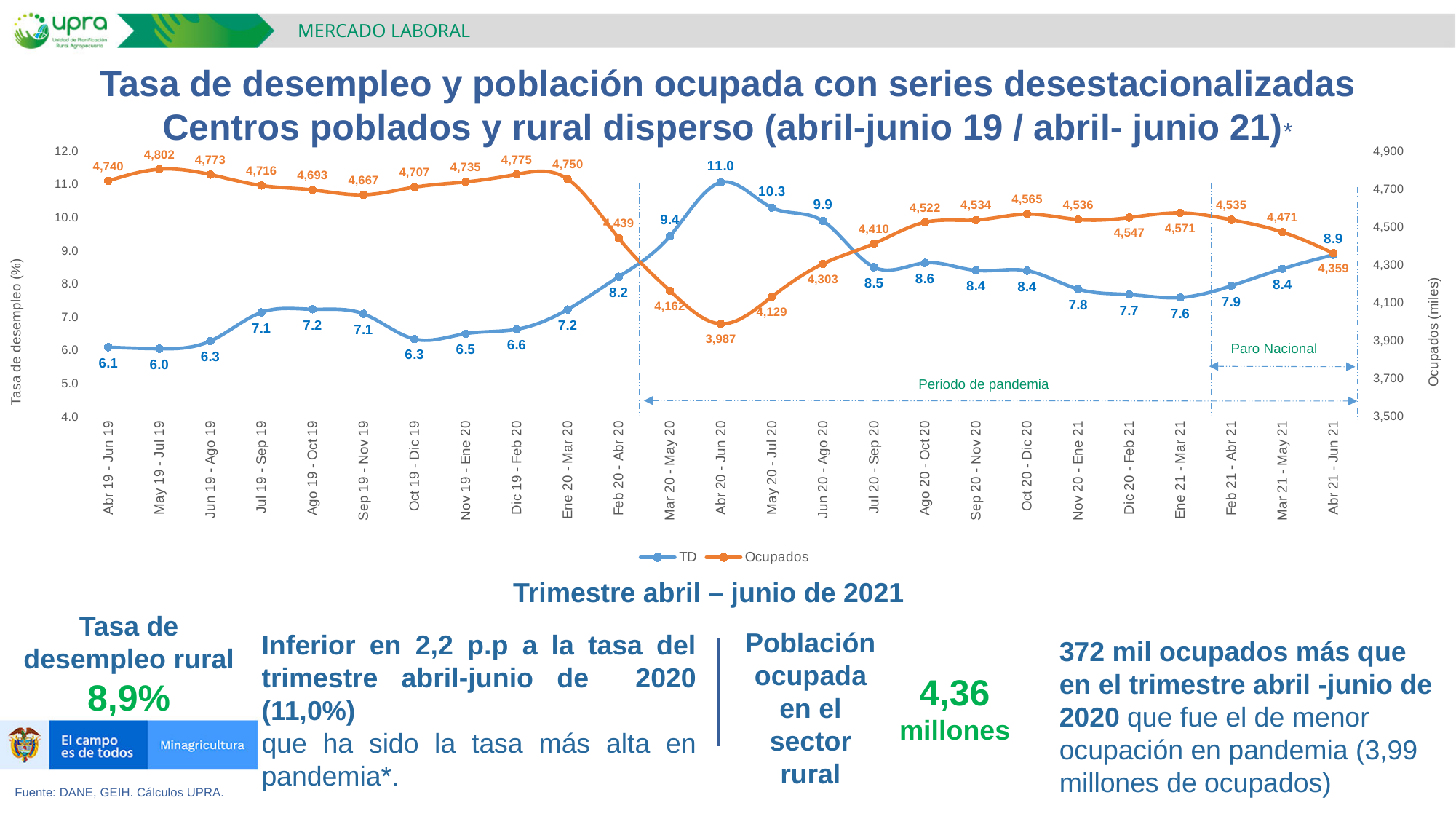
What is the Ocupados value for Abr 20 - Jun 20? 3,987 What is the Ocupados value for Oct 20 - Dic 20? 4,565 What is the TD (unemployment rate) value for Abr 20 - Jun 20? 11.0 In which period is the Ocupados series at its lowest? Abr 20 - Jun 20 What is the difference in Ocupados between Abr 21 - Jun 21 and Abr 20 - Jun 20? 372 Does the TD series rise or fall from Abr 20 - Jun 20 to Ene 21 - Mar 21? Fall How many series does the legend list? 2 In which period is the Ocupados series at its highest? May 19 - Jul 19 Which period has a higher TD value: Mar 20 - May 20 or Jul 20 - Sep 20? Mar 20 - May 20 What kind of chart is shown on the slide? Line chart What is the TD value for Abr 21 - Jun 21? 8.9 In which period is the TD series at its highest? Abr 20 - Jun 20